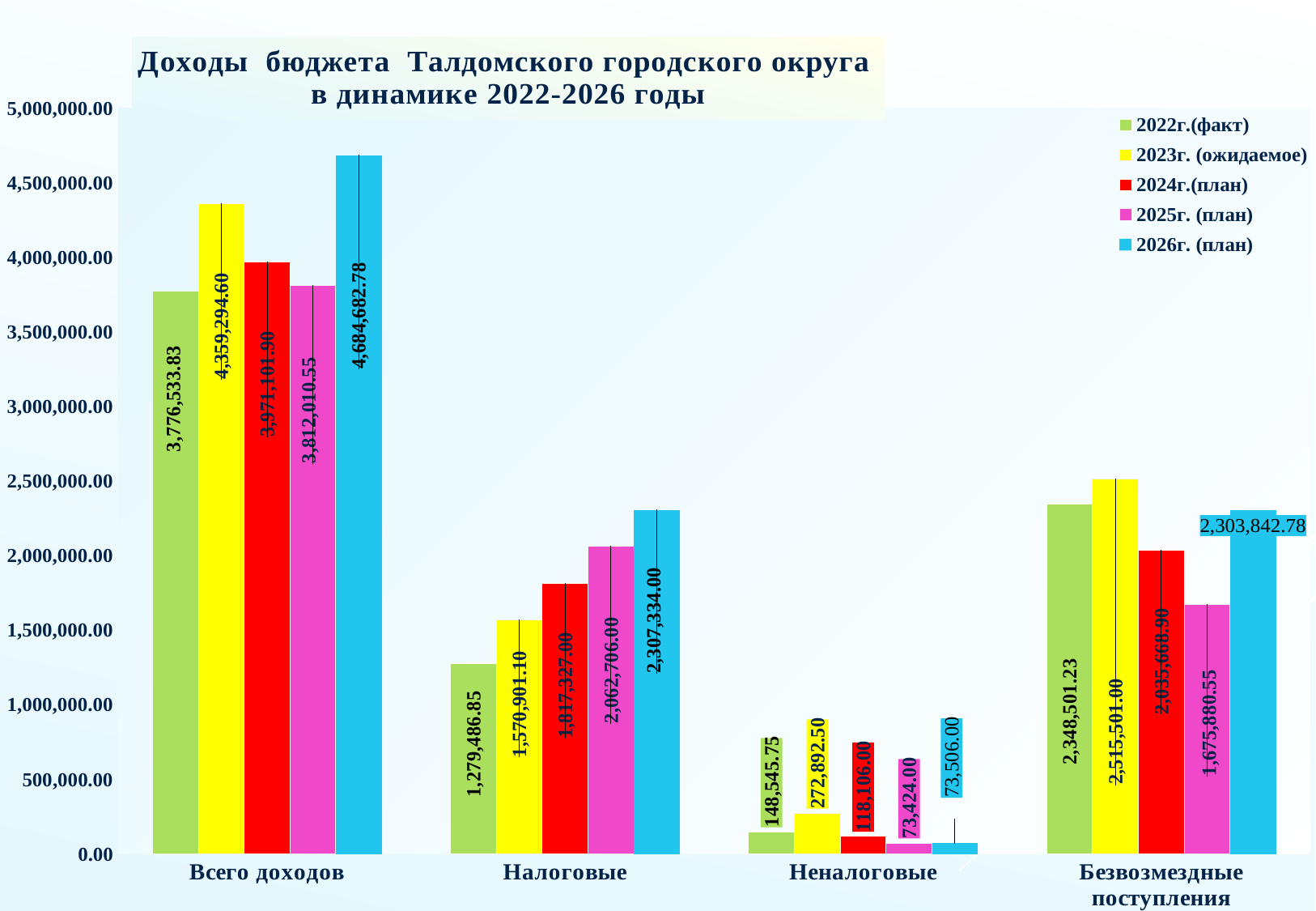
How many categories are shown on the x axis? 4 What is the value for 2026г. (план) in the category Всего доходов? 4,684,682.78 What is the value for 2026г. (план) in the category Налоговые? 2,307,334.00 In the category Неналоговые, which is larger: the value for 2022г.(факт) or for 2023г. (ожидаемое)? 2023г. (ожидаемое) How many series does the legend list? 5 What is the difference between the 2023г. (ожидаемое) and 2022г.(факт) values in the category Неналоговые? 124,346.75 Which series has the highest value in the category Всего доходов? 2026г. (план) Is the value for 2022г.(факт) in the category Налоговые greater or less than 1,500,000.00? less What is the value for 2026г. (план) in the category Безвозмездные поступления? 2,303,842.78 Do the values for Налоговые rise or fall from 2022 to 2026? rise What is the title of the chart? Доходы бюджета Талдомского городского округа в динамике 2022-2026 годы What kind of chart is shown on the slide? bar chart